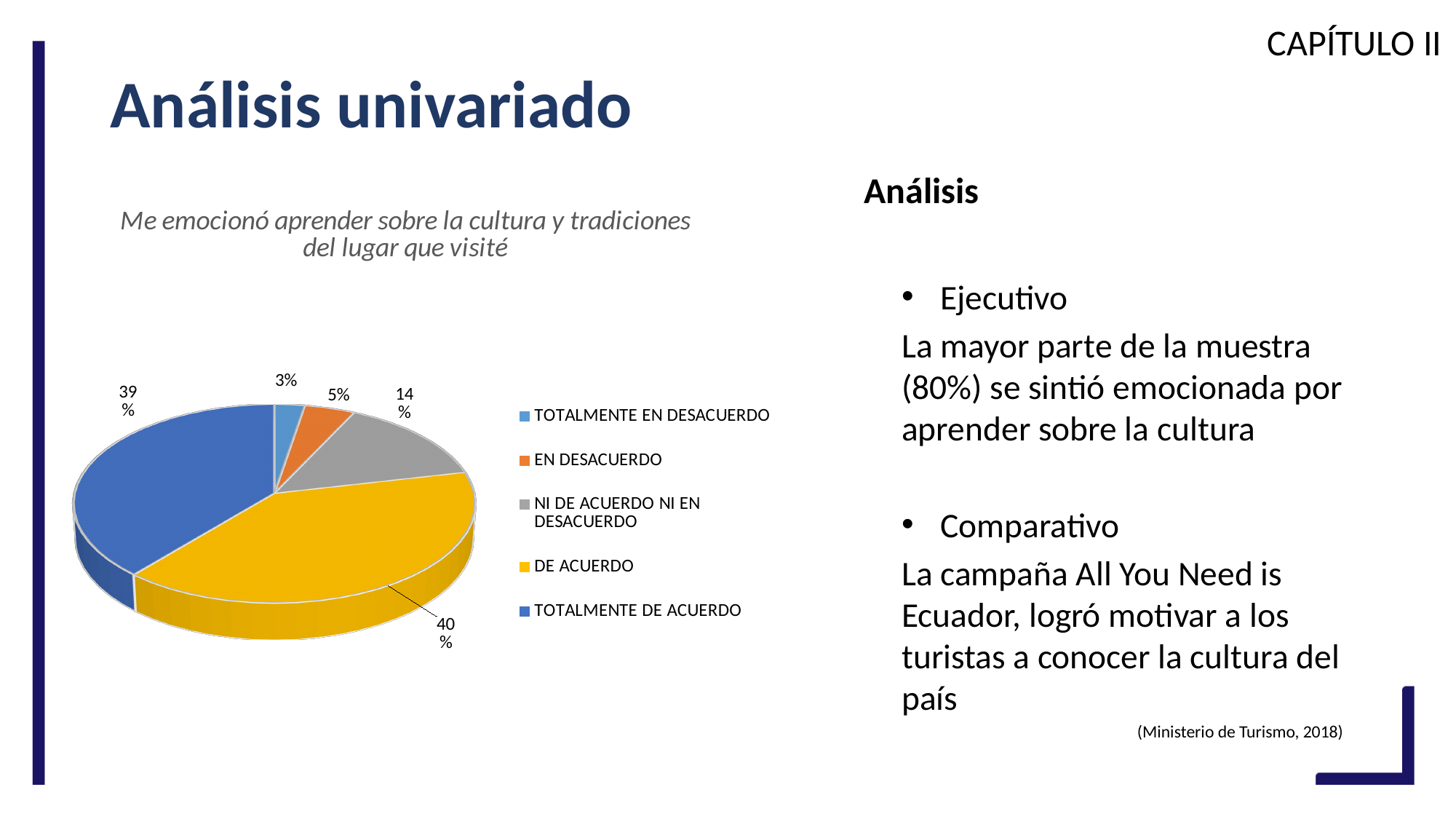
Which category has the smallest slice in the pie chart? TOTALMENTE EN DESACUERDO What percentage of the pie chart corresponds to DE ACUERDO? 40% What percentage of the pie chart corresponds to TOTALMENTE DE ACUERDO? 39% Which category has the largest slice in the pie chart? DE ACUERDO Which slice is larger: NI DE ACUERDO NI EN DESACUERDO or EN DESACUERDO? NI DE ACUERDO NI EN DESACUERDO What percentage of the pie chart corresponds to NI DE ACUERDO NI EN DESACUERDO? 14% How many categories does the pie chart show? 5 What is the difference in percentage points between DE ACUERDO and TOTALMENTE EN DESACUERDO? 37 What percentage of the pie chart corresponds to EN DESACUERDO? 5% What percentage of the pie chart corresponds to TOTALMENTE EN DESACUERDO? 3% What type of chart is shown on the slide? Pie chart What is the title of the chart? Me emocionó aprender sobre la cultura y tradiciones del lugar que visité